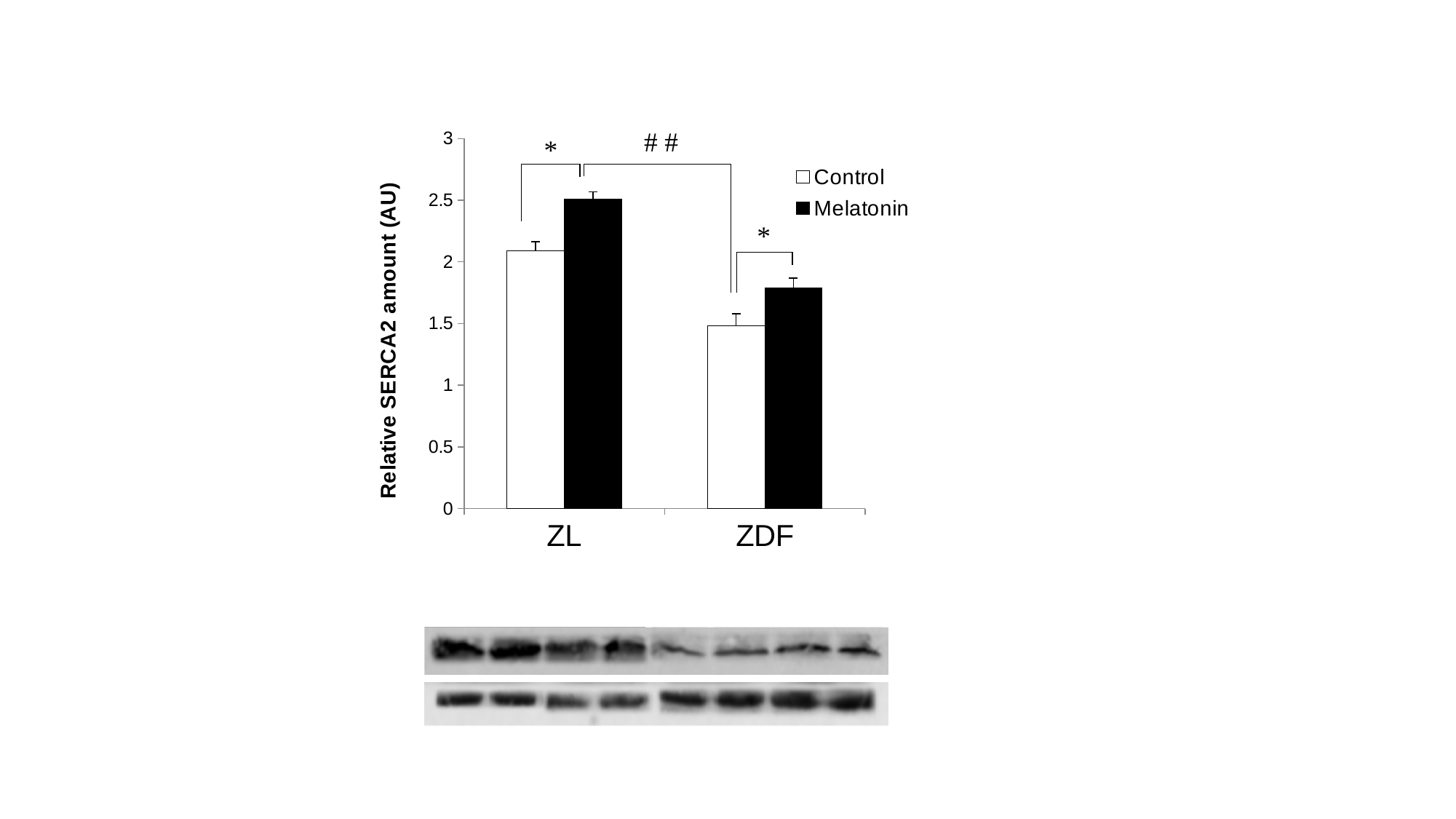
How many series does the legend list? 2 Which series is shown with black bars? Melatonin Which bar is the lowest in the chart? ZDF Control Is the Control value for ZL greater or less than 1.5? greater What is the title of the y axis? Relative SERCA2 amount (AU) What kind of chart is shown on the slide? bar chart Which bar is the highest in the chart? ZL Melatonin Is the Melatonin value for ZDF greater or less than 2? less Which is larger: the Control value for ZL or the Melatonin value for ZDF? Control value for ZL Is the Melatonin value for ZL greater or less than 2? greater How many categories are shown on the x axis? 2